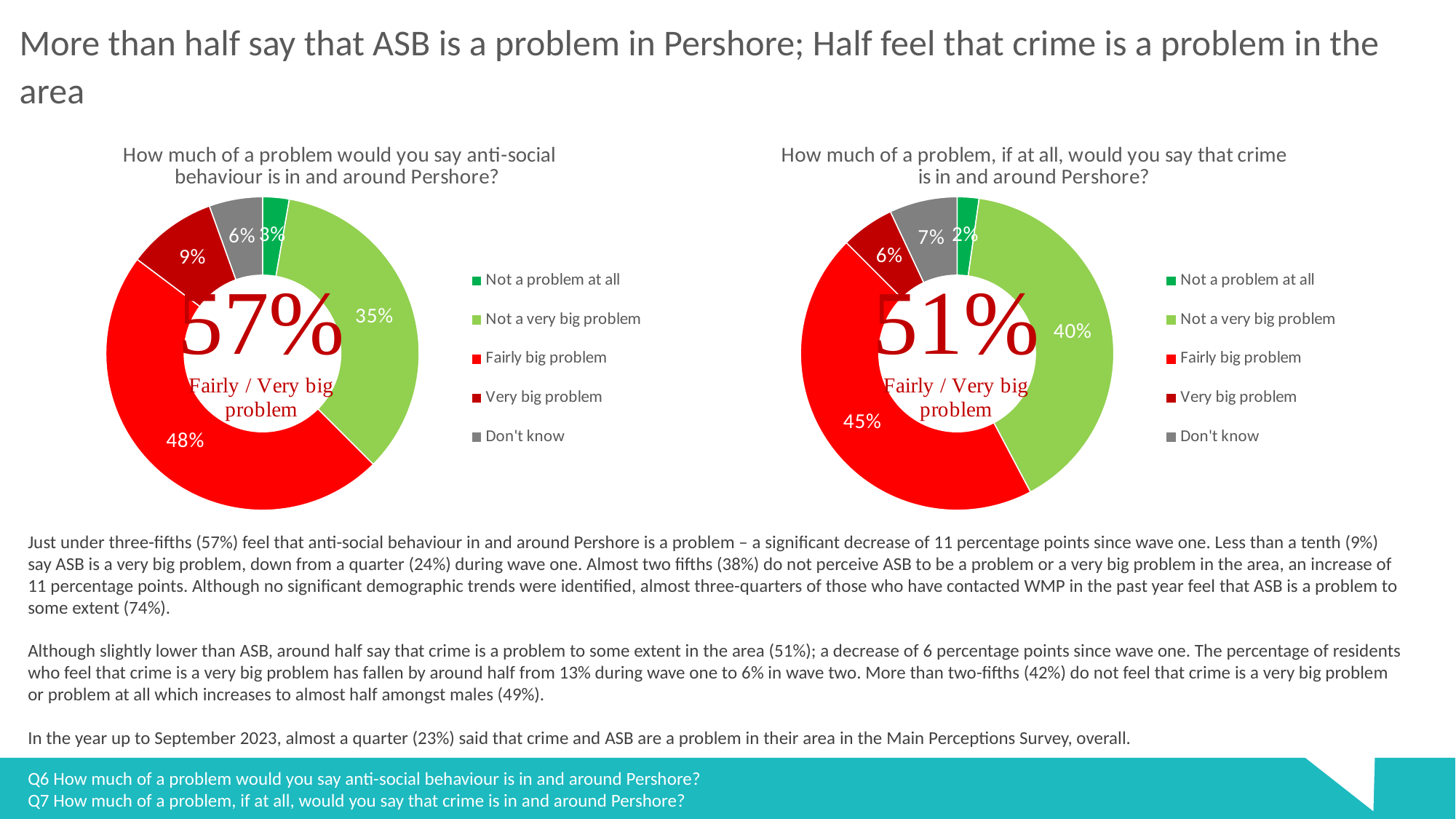
In the right chart about crime, which response has the smallest share? Not a problem at all What combined 'Fairly / Very big problem' figure is shown in the centre of the right chart about crime? 51% In the left chart about anti-social behaviour, what is the difference between the 'Fairly big problem' and 'Not a very big problem' shares? 13 percentage points What type of chart is used on this slide? Pie (donut) chart In the right chart about crime, what percentage said it is not a very big problem? 40% In the left chart about anti-social behaviour, what colour represents 'Very big problem'? Dark red In the left chart about anti-social behaviour, what percentage said it is a fairly big problem? 48% In the left chart about anti-social behaviour, what percentage answered 'Don't know'? 6% In the left chart about anti-social behaviour, which response has the largest share? Fairly big problem How many categories does the legend of the left chart about anti-social behaviour list? 5 In the right chart about crime, what percentage said it is a very big problem? 6% Which is larger in the right chart about crime: the 'Don't know' share or the 'Very big problem' share? Don't know